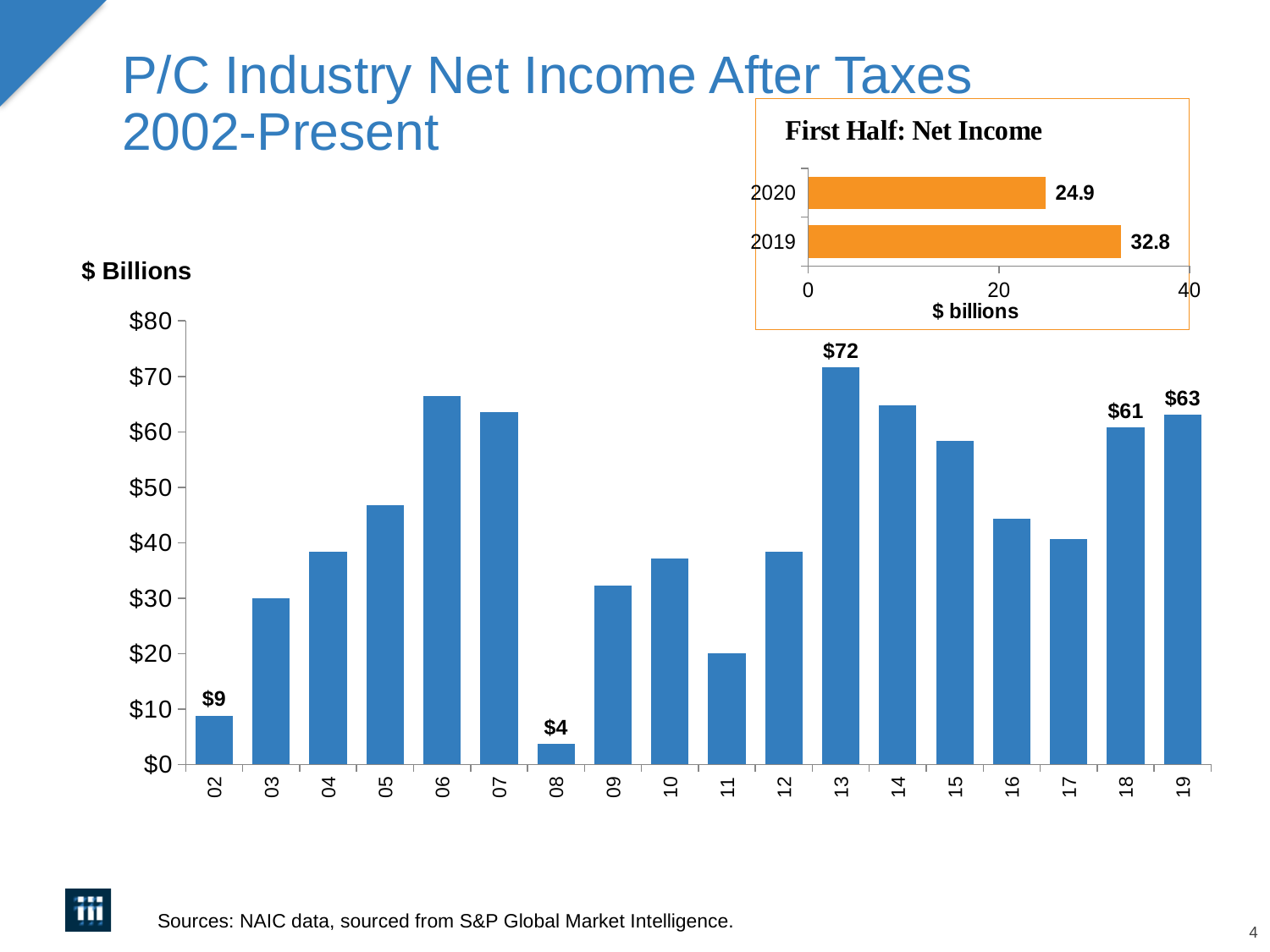
In the main chart, what is the net income value labeled for 2013? $72 In the 'First Half: Net Income' chart, what is the value for 2020? 24.9 In the main chart, what is the net income value labeled for 2019? $63 In the 'First Half: Net Income' chart, which year has the larger value, 2019 or 2020? 2019 In the main chart, which year has the lowest net income? 08 In the main chart, what is the net income value labeled for 2008? $4 In the main chart, what is the difference between the labeled values for 2019 and 2018? $2 In the main chart, is the value for 2006 greater or less than $60? greater In the main chart, is the value for 2011 greater or less than $30? less In the main chart, how many years are shown on the x axis? 18 In the main chart, which year has the highest net income? 13 What kind of chart is the 'First Half: Net Income' chart? bar chart